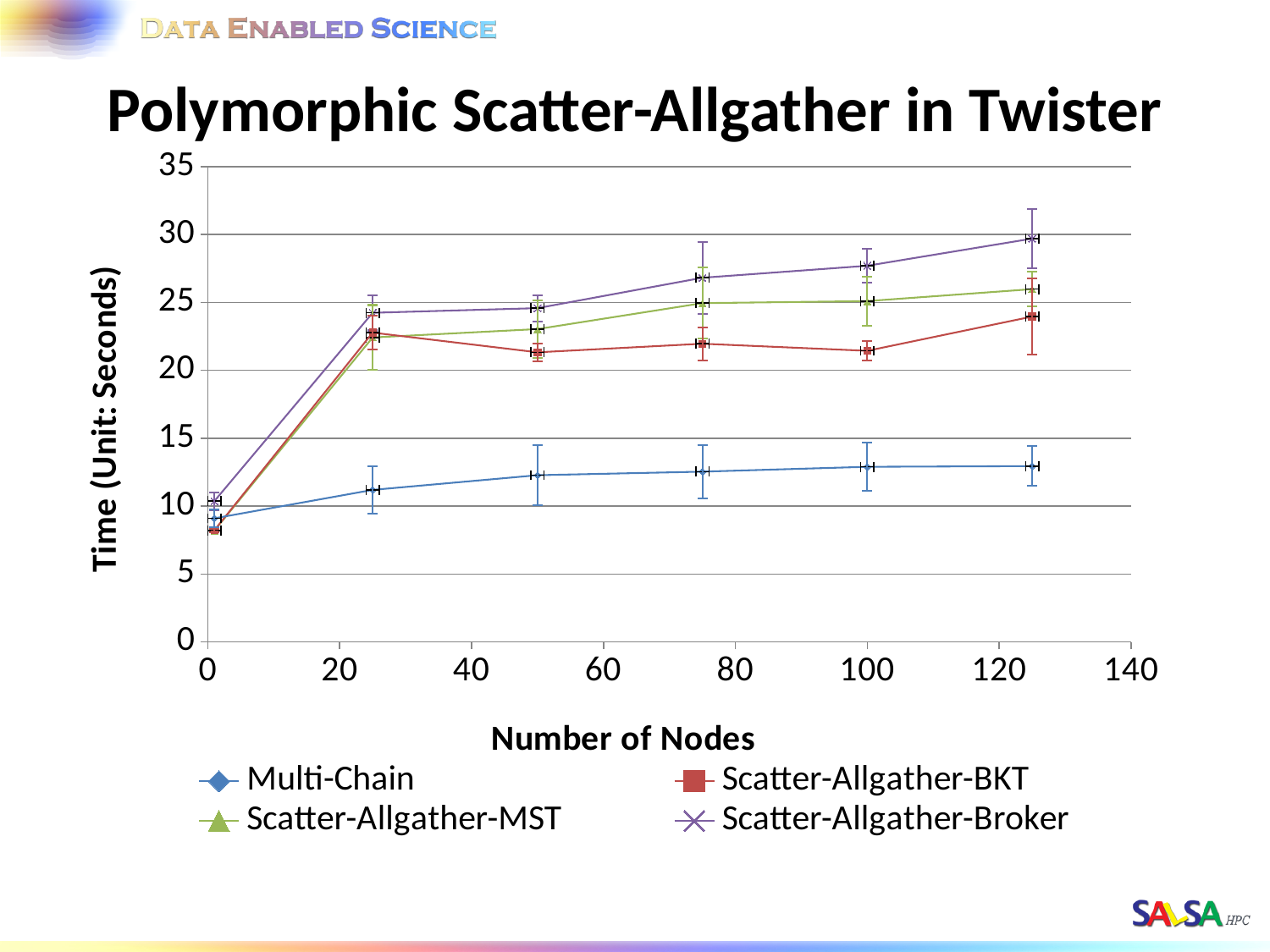
Is the value for Multi-Chain at 125 nodes greater or less than 15? less Is the value for Scatter-Allgather-BKT at 100 nodes greater or less than 25? less Which series has the highest time at 125 nodes? Scatter-Allgather-Broker Is the value for Scatter-Allgather-Broker at 125 nodes greater or less than 25? greater What is the title of the chart? Polymorphic Scatter-Allgather in Twister At 125 nodes, which is larger: Scatter-Allgather-Broker or Multi-Chain? Scatter-Allgather-Broker What kind of chart is shown on the slide? line chart How many series does the legend list? 4 What is the label of the vertical axis? Time (Unit: Seconds) Does the Multi-Chain time rise or fall as the number of nodes increases? rise Which series has the lowest time at 125 nodes? Multi-Chain